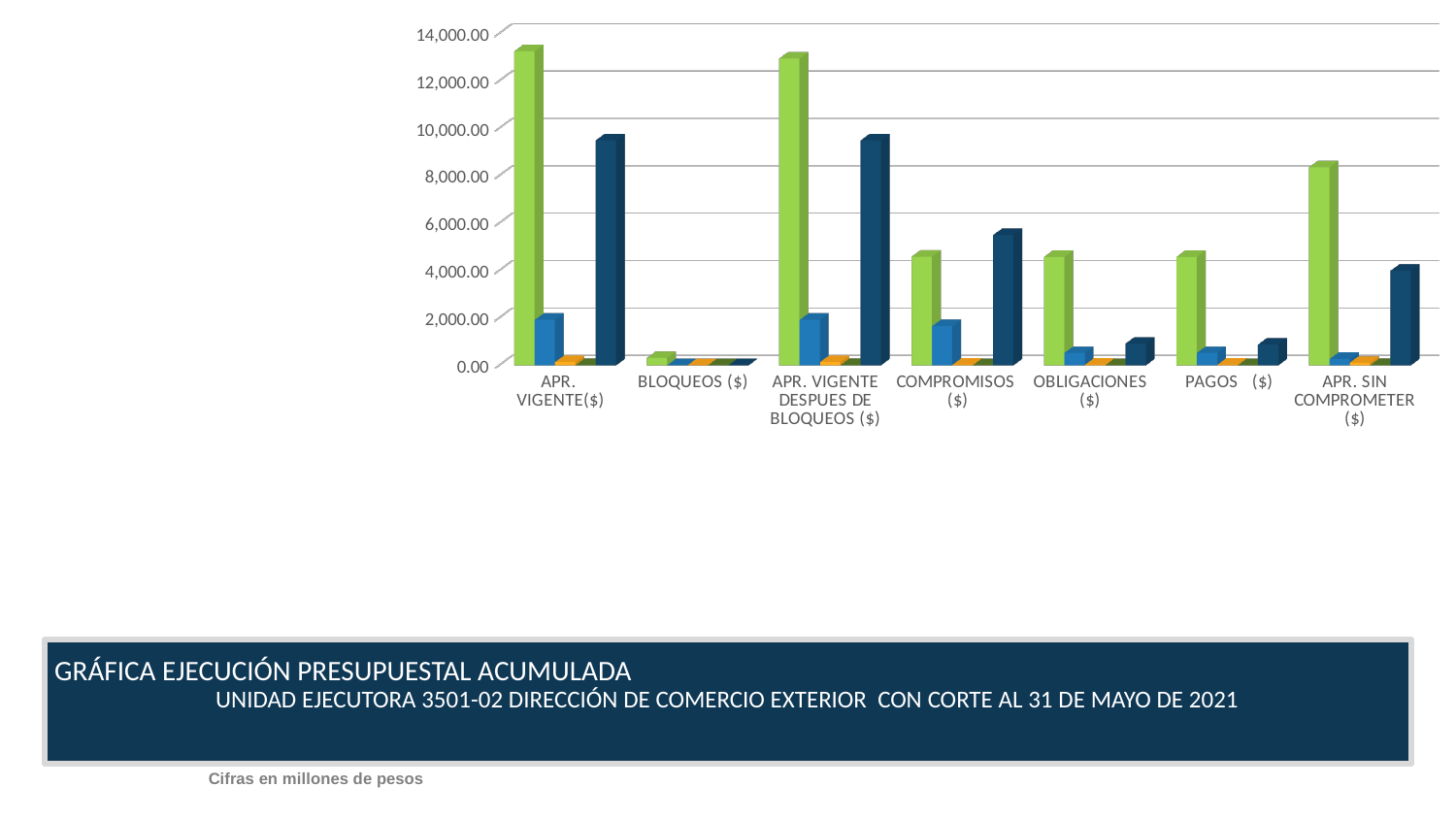
Which is larger for COMPROMISOS ($): the light green bar or the dark blue bar? the dark blue bar Is the dark blue bar for COMPROMISOS ($) greater or less than 4,000.00? greater Is the light green bar for BLOQUEOS ($) greater or less than 2,000.00? less Is the light green bar for APR. VIGENTE($) greater or less than 12,000.00? greater What kind of chart is shown on the slide? bar chart Which category has the tallest bar in the chart? APR. VIGENTE($) What is the highest value shown on the vertical axis of the chart? 14,000.00 Which is larger: the light green bar for APR. VIGENTE($) or the light green bar for APR. SIN COMPROMETER ($)? APR. VIGENTE($) How many categories are shown on the x axis of the chart? 7 Which category has the lowest bars overall in the chart? BLOQUEOS ($)